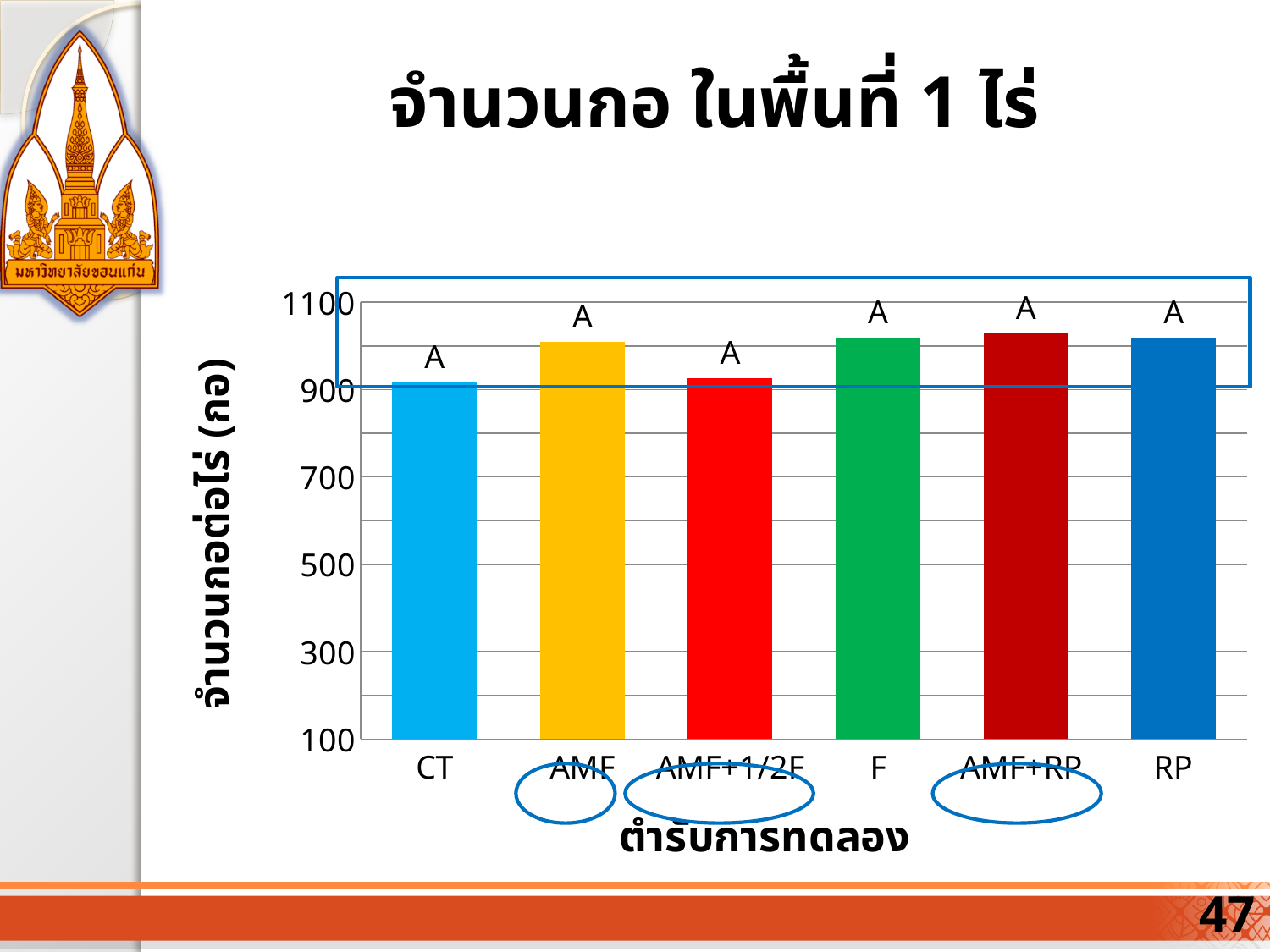
Is the value for F greater or less than 900? greater Is the value for RP greater or less than 700? greater Is the value for AMF+RP greater or less than 1100? less How many categories (treatments) are shown on the x axis? 6 Which has the larger value, CT or AMF+RP? AMF+RP What is the title of the chart? จำนวนกอ ในพื้นที่ 1 ไร่ What is the x-axis title of the chart? ตำรับการทดลอง Which has the larger value, AMF+1/2F or F? F What kind of chart is shown on the slide? bar chart Which has the larger value, CT or AMF? AMF